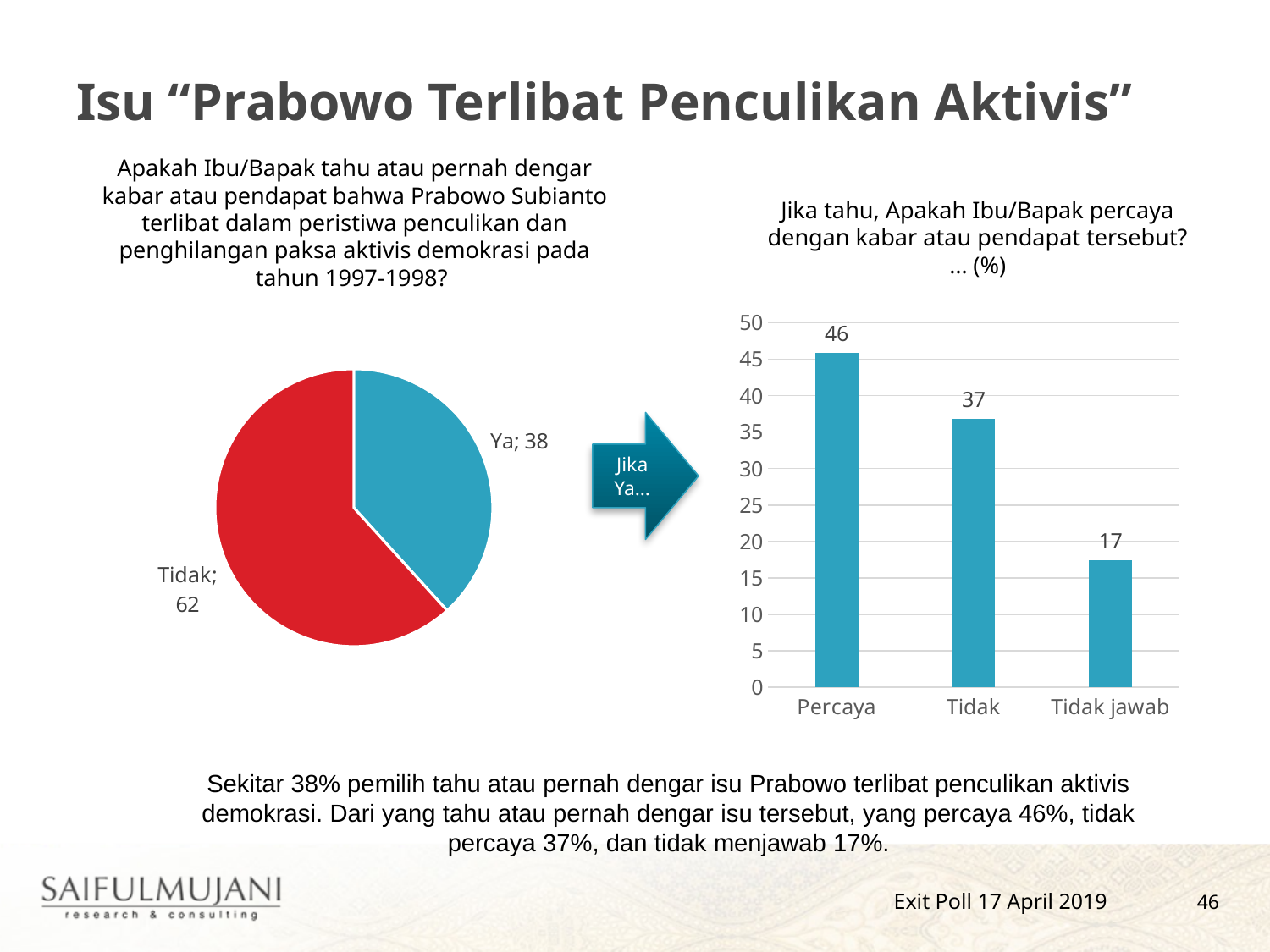
In the pie chart on the left, what is the difference between the "Tidak" and "Ya" values? 24 In the bar chart on the right, what is the difference between the "Percaya" and "Tidak" values? 9 How many slices does the pie chart on the left have? 2 In the pie chart on the left, what is the value for "Tidak"? 62 What type of chart is the chart on the right of the slide? Bar chart In the bar chart on the right, which category has the lowest value? Tidak jawab In the pie chart on the left, which slice is larger, "Ya" or "Tidak"? Tidak In the bar chart on the right, what is the value for "Tidak jawab"? 17 What type of chart is the chart on the left of the slide? Pie chart In the pie chart on the left, what is the value for "Ya"? 38 In the bar chart on the right, which category has the highest value? Percaya In the bar chart on the right, what is the value for "Percaya"? 46